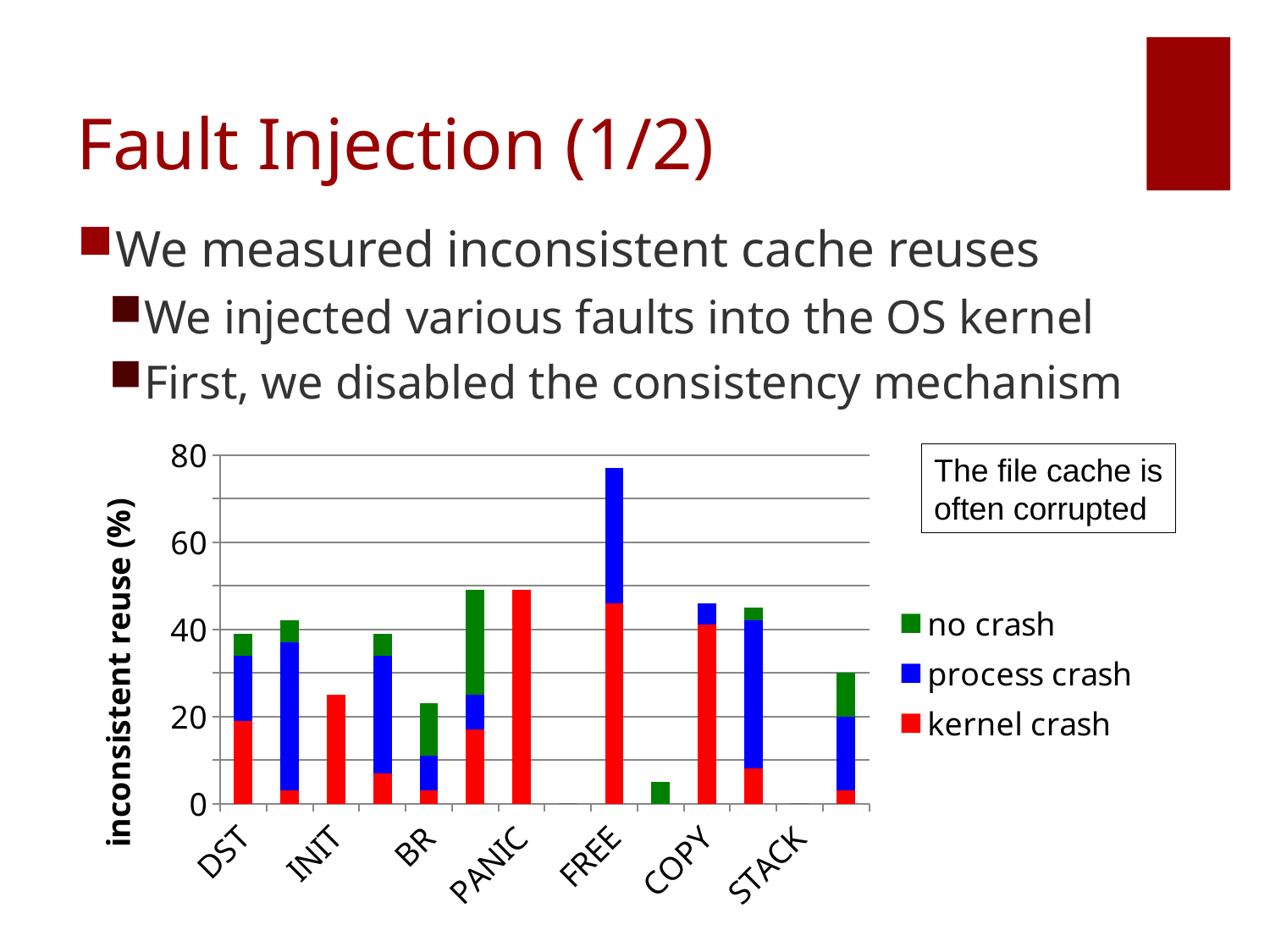
How many series does the chart's legend list? 3 Which is larger, the total bar for FREE or the total bar for INIT? FREE What is the title of the chart's vertical axis? inconsistent reuse (%) Which labeled category has the tallest bar in the chart? FREE Is the total value of the bar for PANIC greater or less than 40? greater What kind of chart is shown on the slide? stacked bar chart Which is larger, the total bar for PANIC or the total bar for INIT? PANIC Is the total value of the bar for DST greater or less than 20? greater What are the three series named in the chart's legend? no crash, process crash, kernel crash Is the total value of the bar for FREE greater or less than 60? greater